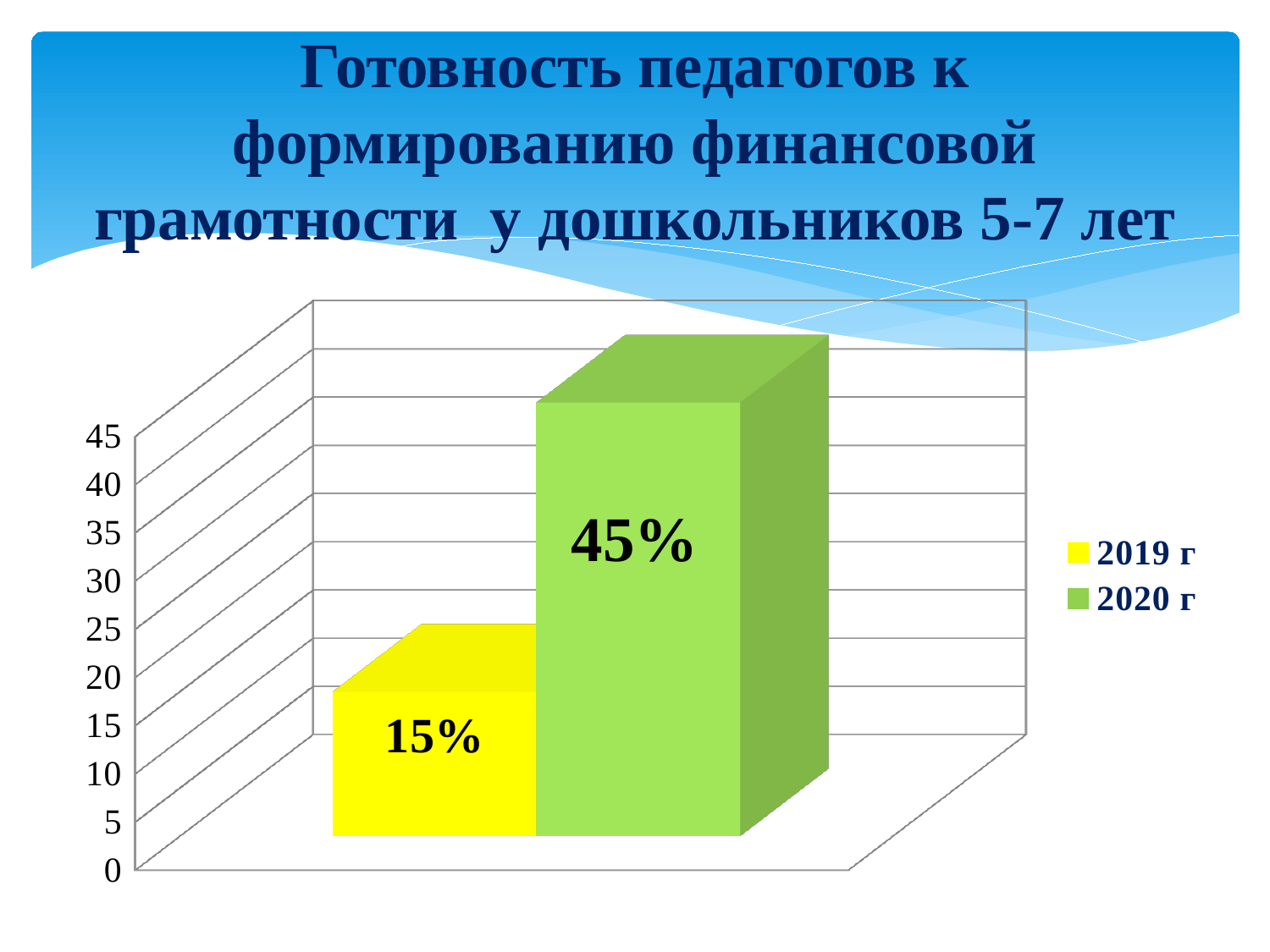
Which series has the highest value? 2020 г What is the difference between the values for 2020 г and 2019 г? 30% Is the value for 2020 г greater or less than 40? greater What colour is the bar for 2020 г? green Which is larger, the value for 2019 г or the value for 2020 г? 2020 г Which series has the lowest value? 2019 г What is the title of the slide? Готовность педагогов к формированию финансовой грамотности у дошкольников 5-7 лет What is the value for 2020 г? 45% What kind of chart is shown on the slide? bar chart How many series does the legend list? 2 What is the value for 2019 г? 15% Is the value for 2019 г greater or less than 20? less